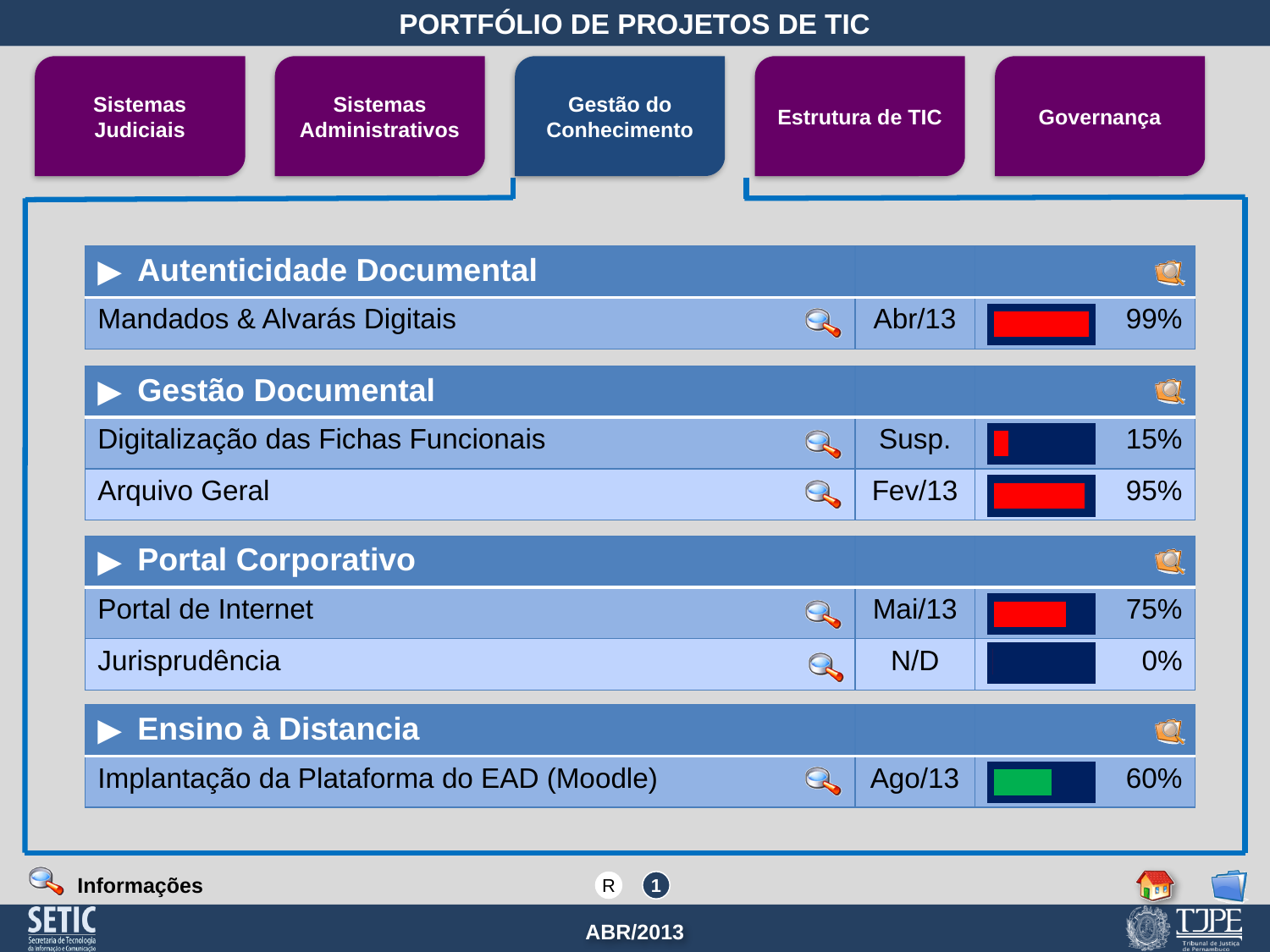
What is the difference in completion percentage between Mandados & Alvarás Digitais and Digitalização das Fichas Funcionais? 84 percentage points What date is shown next to Arquivo Geral? Fev/13 What kind of chart is used to show project progress on the slide? Bar chart What completion percentage is shown for Mandados & Alvarás Digitais? 99% Which project has the highest completion percentage? Mandados & Alvarás Digitais What completion percentage is shown for Portal de Internet? 75% Which has a higher completion percentage, Portal de Internet or Arquivo Geral? Arquivo Geral How many projects have a progress bar on the slide? 6 What colour is the progress bar for Implantação da Plataforma do EAD (Moodle)? Green What completion percentage is shown for Digitalização das Fichas Funcionais? 15% What completion percentage is shown for Implantação da Plataforma do EAD (Moodle)? 60% Which project has the lowest completion percentage? Jurisprudência